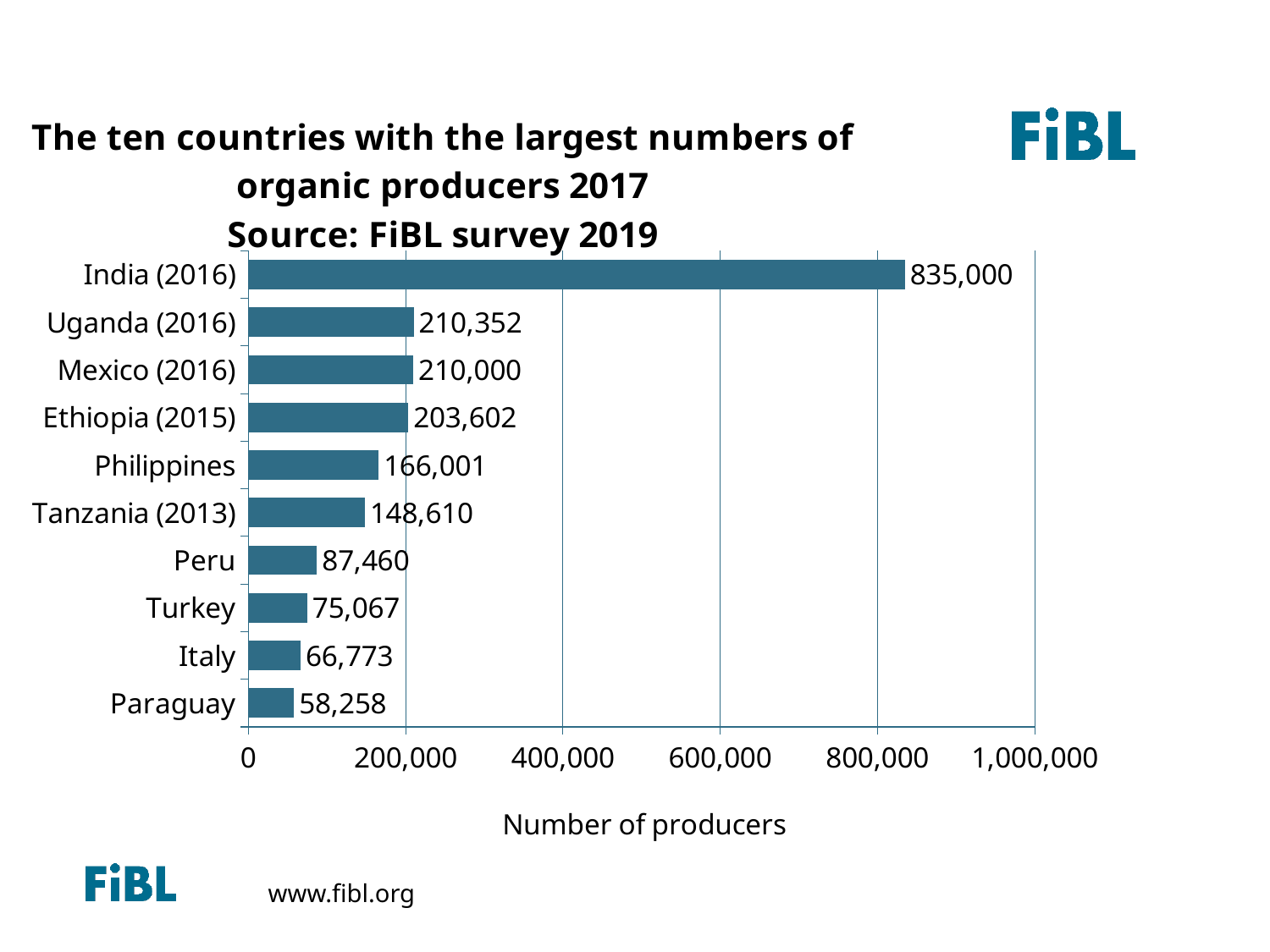
How many countries are shown on the chart? 10 What is the difference in number of producers between Peru and Italy? 20,687 What is the number of producers shown for Ethiopia (2015)? 203,602 What is the label of the horizontal axis? Number of producers What type of chart is shown on the slide? bar chart Which country has the largest number of organic producers on the chart? India (2016) How many organic producers does India (2016) have according to the chart? 835,000 Which country has the smallest number of organic producers on the chart? Paraguay Is the value for Tanzania (2013) greater or less than 200,000? less What is the difference in number of producers between Uganda (2016) and Mexico (2016)? 352 Which has more organic producers, Philippines or Tanzania (2013)? Philippines What is the number of producers shown for Turkey? 75,067